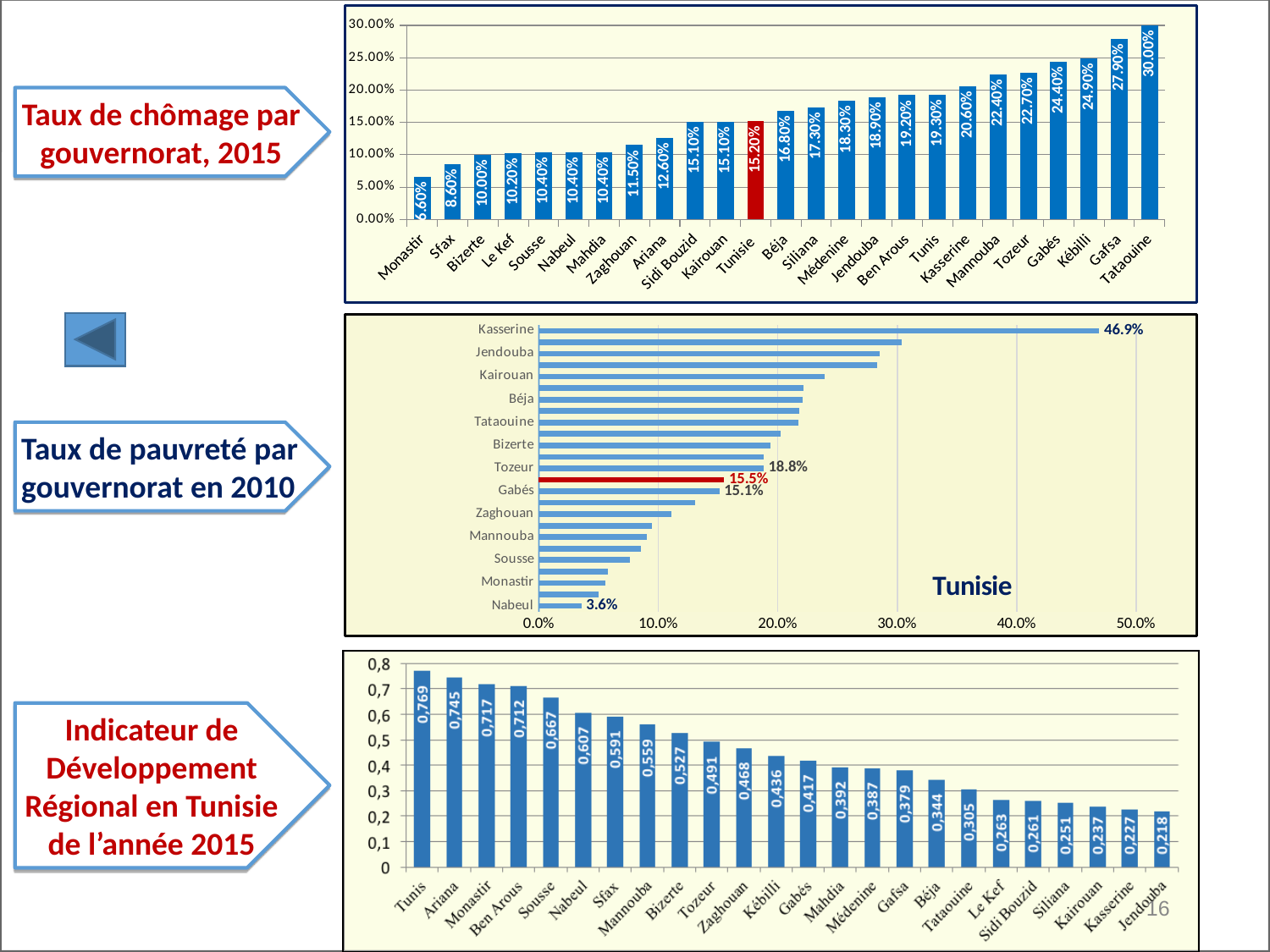
In the 'Indicateur de Développement Régional en Tunisie de l'année 2015' chart, do the values rise or fall from left to right along the x axis? Fall In the 'Taux de chômage par gouvernorat, 2015' chart, which governorate has the highest unemployment rate? Tataouine In the 'Taux de pauvreté par gouvernorat en 2010' chart, is the value for Jendouba greater or less than 20.0%? greater In the 'Taux de chômage par gouvernorat, 2015' chart, which governorate has the lowest unemployment rate? Monastir In the 'Taux de chômage par gouvernorat, 2015' chart, what is the value of the red bar labelled Tunisie? 15.20% What kind of chart is the 'Taux de pauvreté par gouvernorat en 2010' chart? Bar chart In the 'Taux de chômage par gouvernorat, 2015' chart, what is the unemployment rate for Gafsa? 27.90% In the 'Taux de pauvreté par gouvernorat en 2010' chart, what is the poverty rate for Kasserine? 46.9% In the 'Taux de pauvreté par gouvernorat en 2010' chart, what is the poverty rate for Nabeul? 3.6% In the 'Indicateur de Développement Régional en Tunisie de l'année 2015' chart, which governorate has the lowest value? Jendouba In the 'Taux de chômage par gouvernorat, 2015' chart, what is the difference between the unemployment rates of Tataouine and Monastir? 23.40% In the 'Indicateur de Développement Régional en Tunisie de l'année 2015' chart, what is the value for Sousse? 0,667